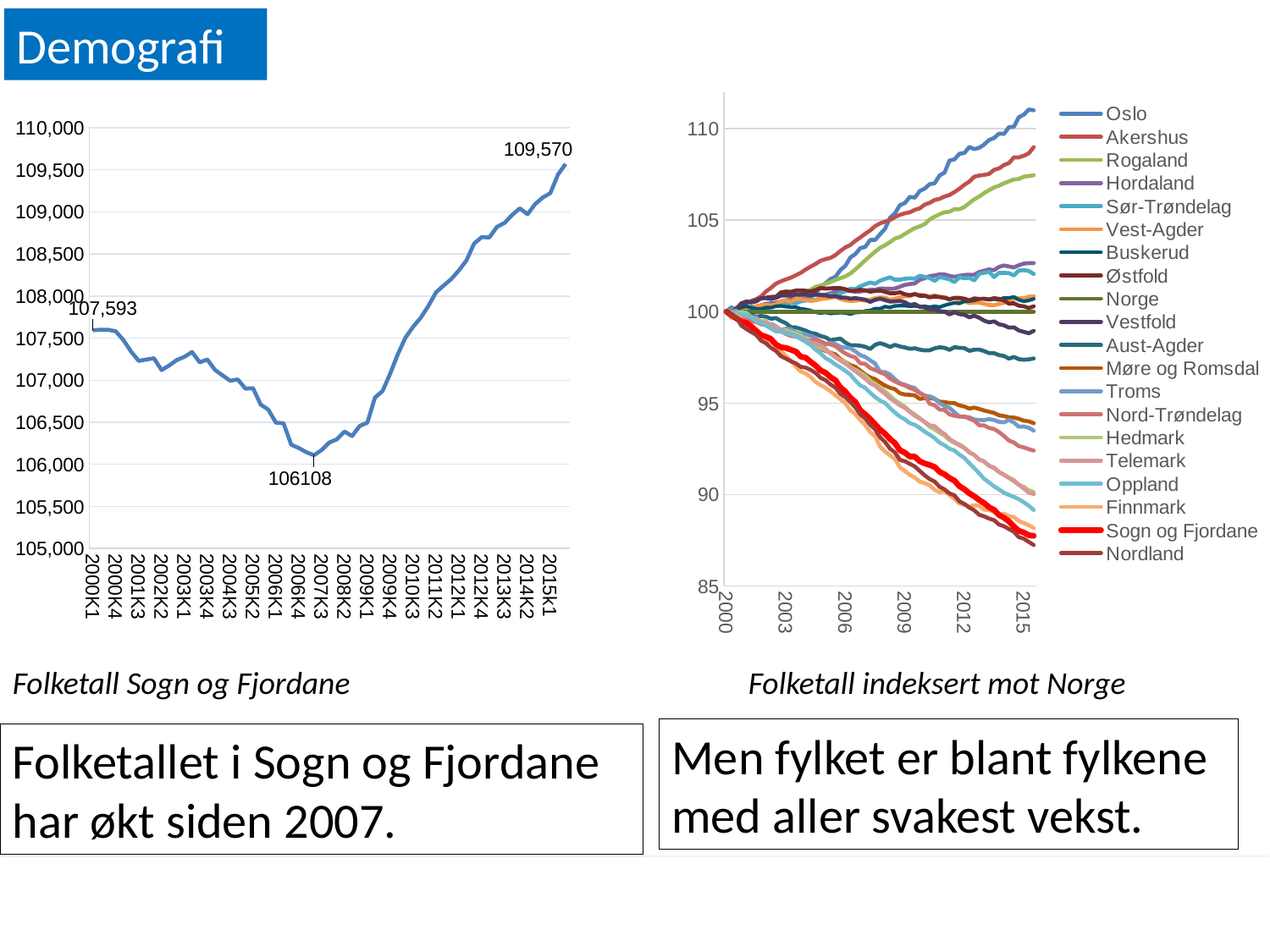
What kind of chart is the left chart, 'Folketall Sogn og Fjordane'? line chart In the left chart 'Folketall Sogn og Fjordane', what is the labelled value at the lowest point of the line? 106108 In the right chart 'Folketall indeksert mot Norge', does the Sogn og Fjordane line rise or fall from 2000 to 2015? fall In the right chart 'Folketall indeksert mot Norge', is the value for Sogn og Fjordane at 2015 greater or less than 90? less In the left chart 'Folketall Sogn og Fjordane', is the value at 2006K4 greater or less than 106,500? less In the right chart 'Folketall indeksert mot Norge', which series has the highest value at 2015? Oslo In the left chart 'Folketall Sogn og Fjordane', what is the labelled value at 2000K1? 107,593 How many series does the legend of the right chart 'Folketall indeksert mot Norge' list? 20 In the left chart 'Folketall Sogn og Fjordane', is the value at 2013K3 greater or less than 108,500? greater In the left chart 'Folketall Sogn og Fjordane', which labelled value is larger: the one at 2000K1 or the one at 2015K1? 2015K1 (109,570) In the left chart 'Folketall Sogn og Fjordane', what is the labelled value at the end of the series (2015K1)? 109,570 In the left chart 'Folketall Sogn og Fjordane', what is the difference between the final labelled value (109,570) and the lowest labelled value (106108)? 3,462